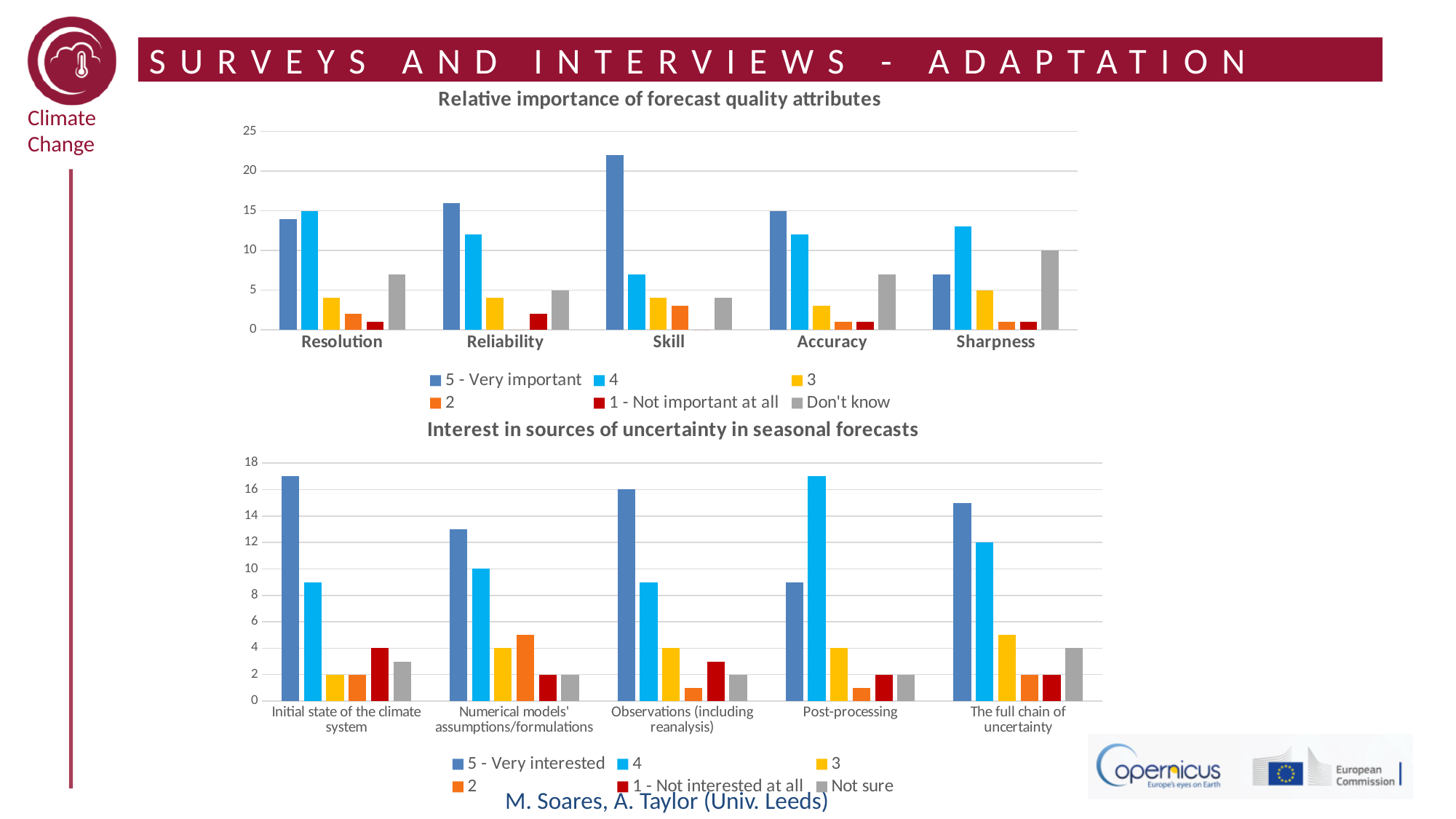
How many series does the legend of the 'Relative importance of forecast quality attributes' chart list? 6 What is the title of the lower chart on the slide? Interest in sources of uncertainty in seasonal forecasts In the 'Relative importance of forecast quality attributes' chart, which attribute has the highest '5 - Very important' bar? Skill In the 'Relative importance of forecast quality attributes' chart, what is the 'Don't know' value for Sharpness? 10 In the 'Relative importance of forecast quality attributes' chart, for Sharpness, which is larger: the '5 - Very important' bar or the '4' bar? 4 In the 'Relative importance of forecast quality attributes' chart, is the '5 - Very important' value for Skill greater or less than 20? greater What kind of chart is the 'Relative importance of forecast quality attributes' chart? bar chart In the 'Interest in sources of uncertainty in seasonal forecasts' chart, which source has the highest '4' bar? Post-processing In the 'Interest in sources of uncertainty in seasonal forecasts' chart, what is the '5 - Very interested' value for Observations (including reanalysis)? 16 In the 'Interest in sources of uncertainty in seasonal forecasts' chart, which has the larger '5 - Very interested' value: Initial state of the climate system or Numerical models' assumptions/formulations? Initial state of the climate system How many forecast quality attributes are shown on the x axis of the 'Relative importance of forecast quality attributes' chart? 5 In the 'Interest in sources of uncertainty in seasonal forecasts' chart, is the '5 - Very interested' value for Post-processing greater or less than 10? less